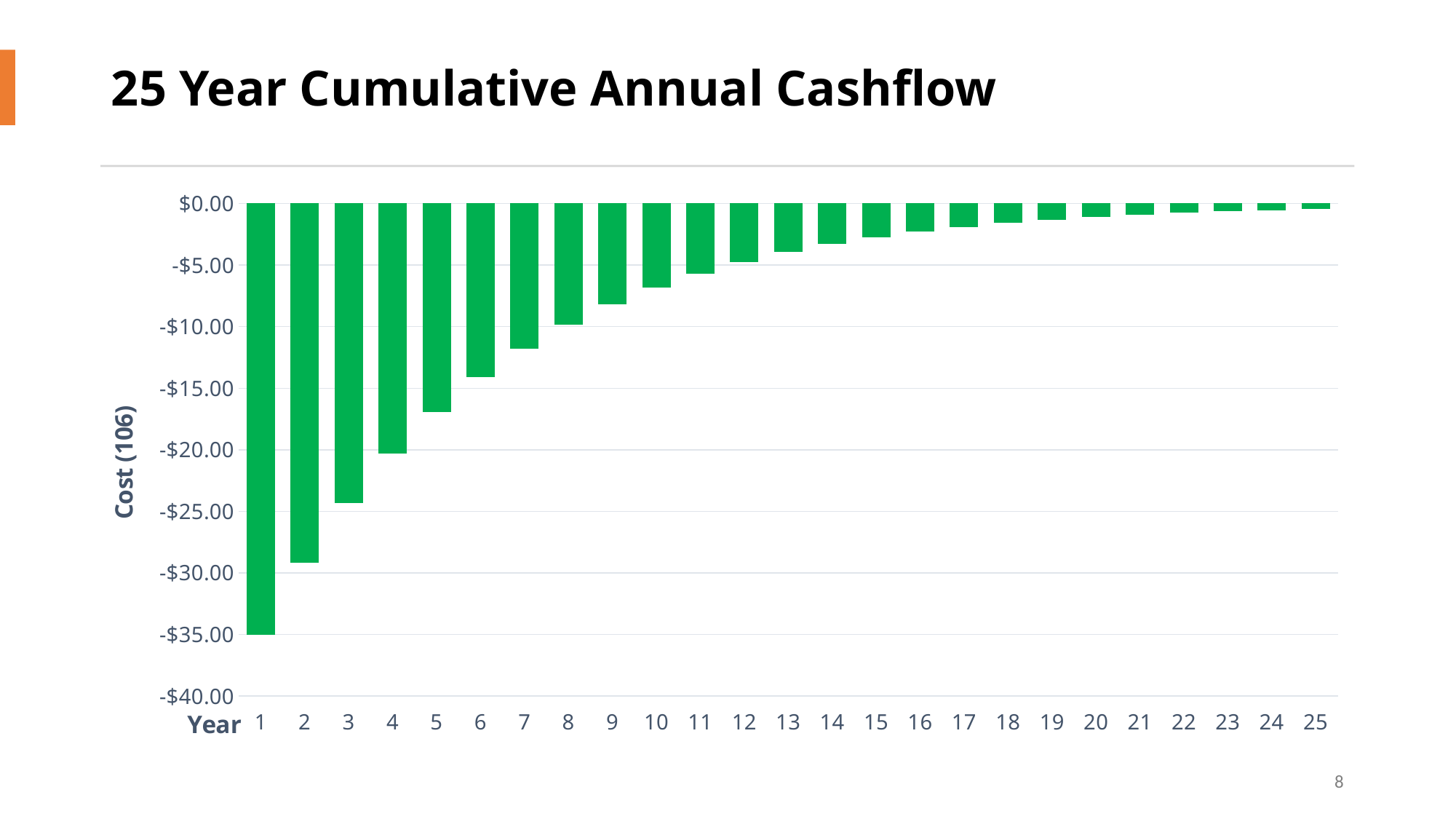
Is the value for year 5 greater or less than -$15.00? less What is the cumulative cashflow value for year 1? -$35.00 Which year has the lowest (most negative) cumulative cashflow? 1 Which has the larger (less negative) value, year 3 or year 8? year 8 Do the values rise or fall as the year increases along the x axis? rise Is the value for year 10 greater or less than -$5.00? less How many years (bars) are plotted on the chart? 25 Which year has the highest (least negative) cumulative cashflow? 25 Is the value for year 2 greater or less than -$25.00? less What kind of chart is shown on the slide? bar chart What is the title of the vertical axis? Cost (106)